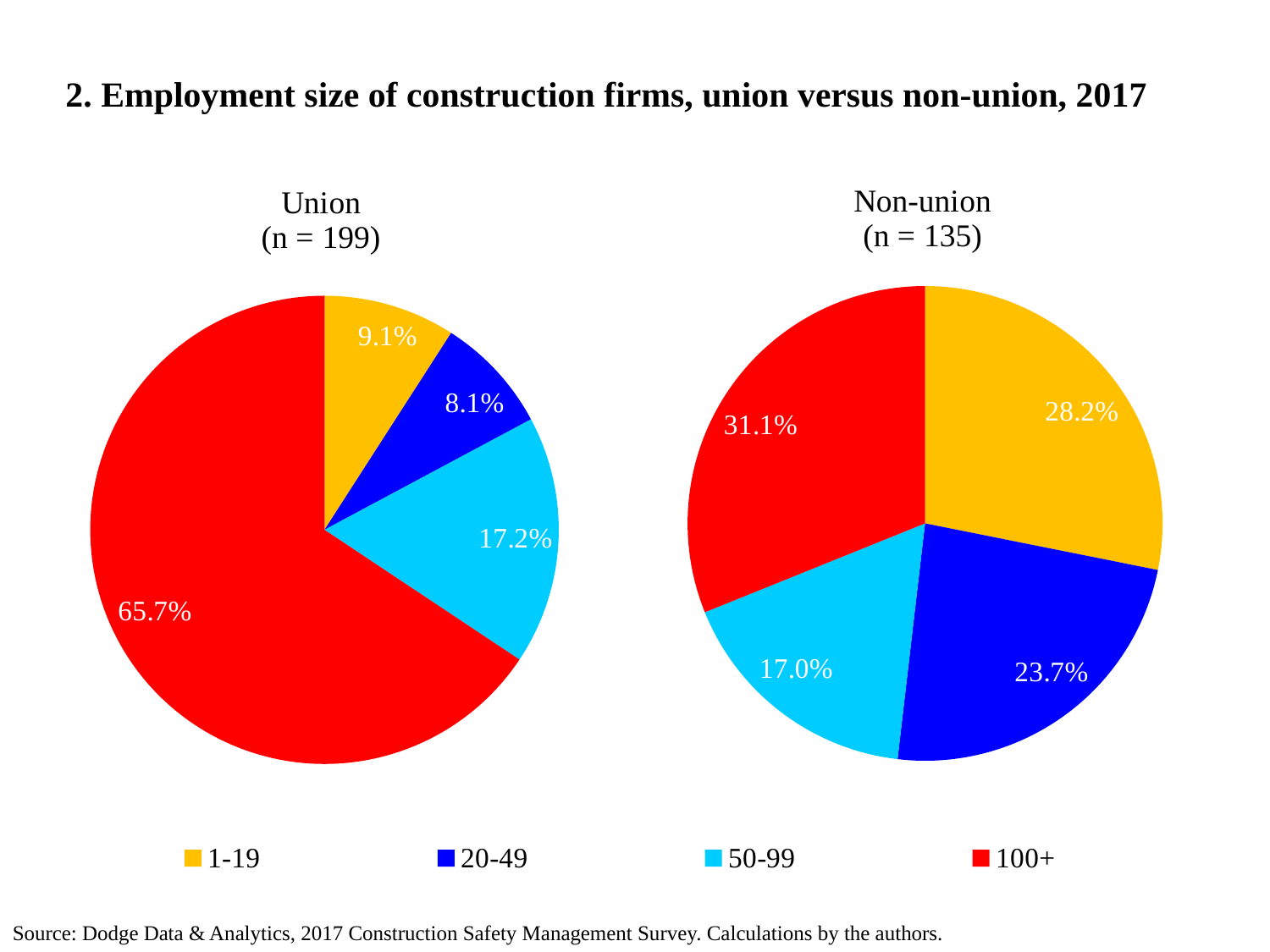
In the Non-union pie chart, which employment size category has the smallest share? 50-99 What is the difference between the 100+ share in the Union pie chart and the 100+ share in the Non-union pie chart? 34.6% How many categories does the legend list? 4 In the Union pie chart, which employment size category has the smallest share? 20-49 In the Union pie chart, what share of firms have 100+ employees? 65.7% In the Non-union pie chart, what is the value for the 50-99 category? 17.0% What kind of charts are shown on the slide? Pie charts In the Union pie chart, which employment size category has the largest share? 100+ In the Non-union pie chart, what share of firms have 1-19 employees? 28.2% Which is larger: the 20-49 share in the Union pie chart or the 20-49 share in the Non-union pie chart? Non-union In the Union pie chart, what is the value for the 20-49 category? 8.1% What is the sample size (n) shown for the Non-union pie chart? 135